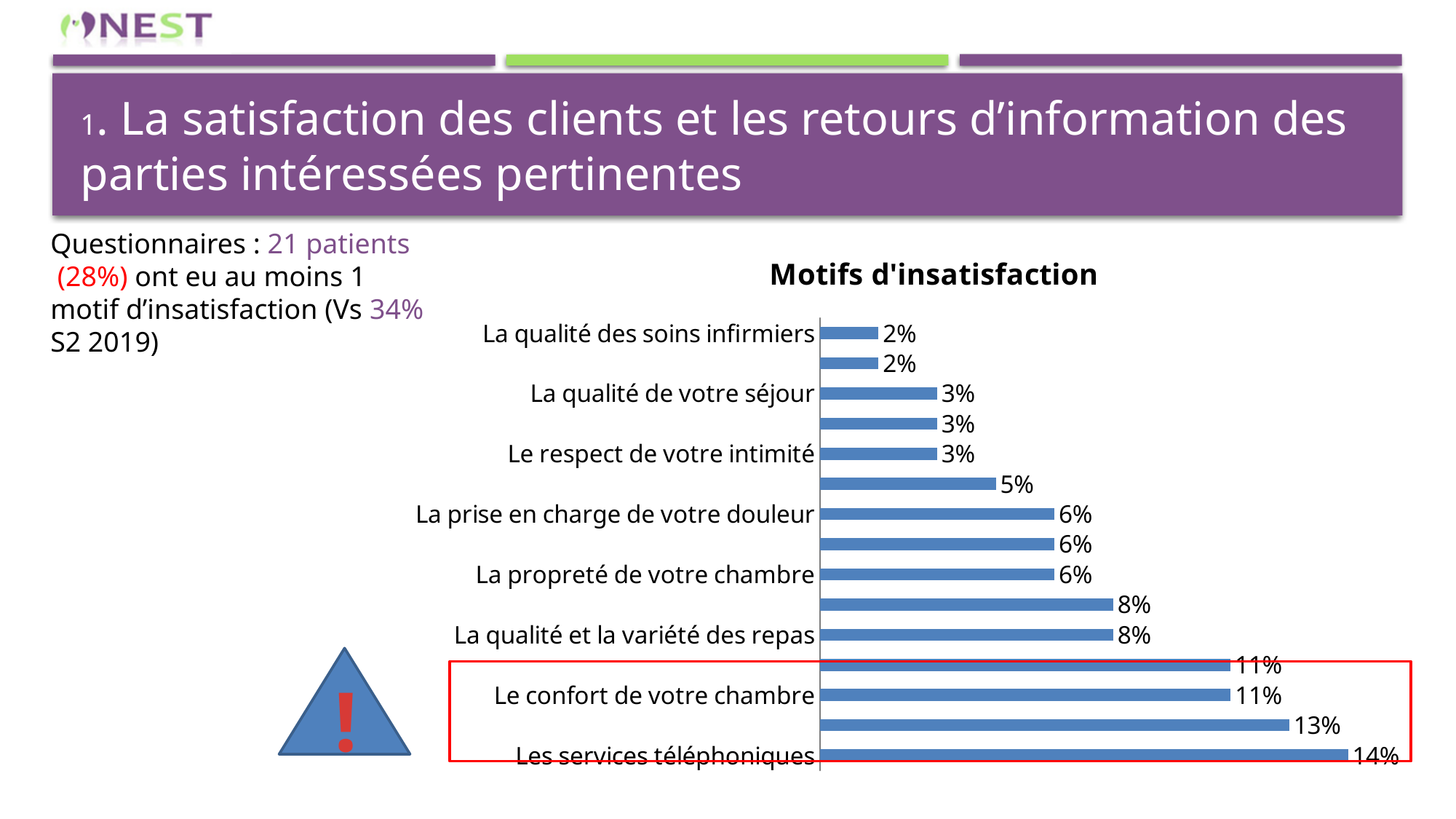
What kind of chart is the 'Motifs d'insatisfaction' chart? Bar chart What is the lowest value shown in the 'Motifs d'insatisfaction' chart? 2% What is the value for 'La prise en charge de votre douleur' in the 'Motifs d'insatisfaction' chart? 6% Which is larger in the 'Motifs d'insatisfaction' chart: 'La qualité et la variété des repas' or 'La propreté de votre chambre'? La qualité et la variété des repas What is the value for 'La qualité des soins infirmiers' in the 'Motifs d'insatisfaction' chart? 2% What is the difference between the values for 'Les services téléphoniques' and 'Le confort de votre chambre' in the 'Motifs d'insatisfaction' chart? 3% What is the value for 'Le confort de votre chambre' in the 'Motifs d'insatisfaction' chart? 11% Which labelled category has the highest value in the 'Motifs d'insatisfaction' chart? Les services téléphoniques What is the value for 'Les services téléphoniques' in the 'Motifs d'insatisfaction' chart? 14% How many bars are plotted in the 'Motifs d'insatisfaction' chart? 15 What is the value for 'La qualité et la variété des repas' in the 'Motifs d'insatisfaction' chart? 8% What is the title of the chart on the slide? Motifs d'insatisfaction